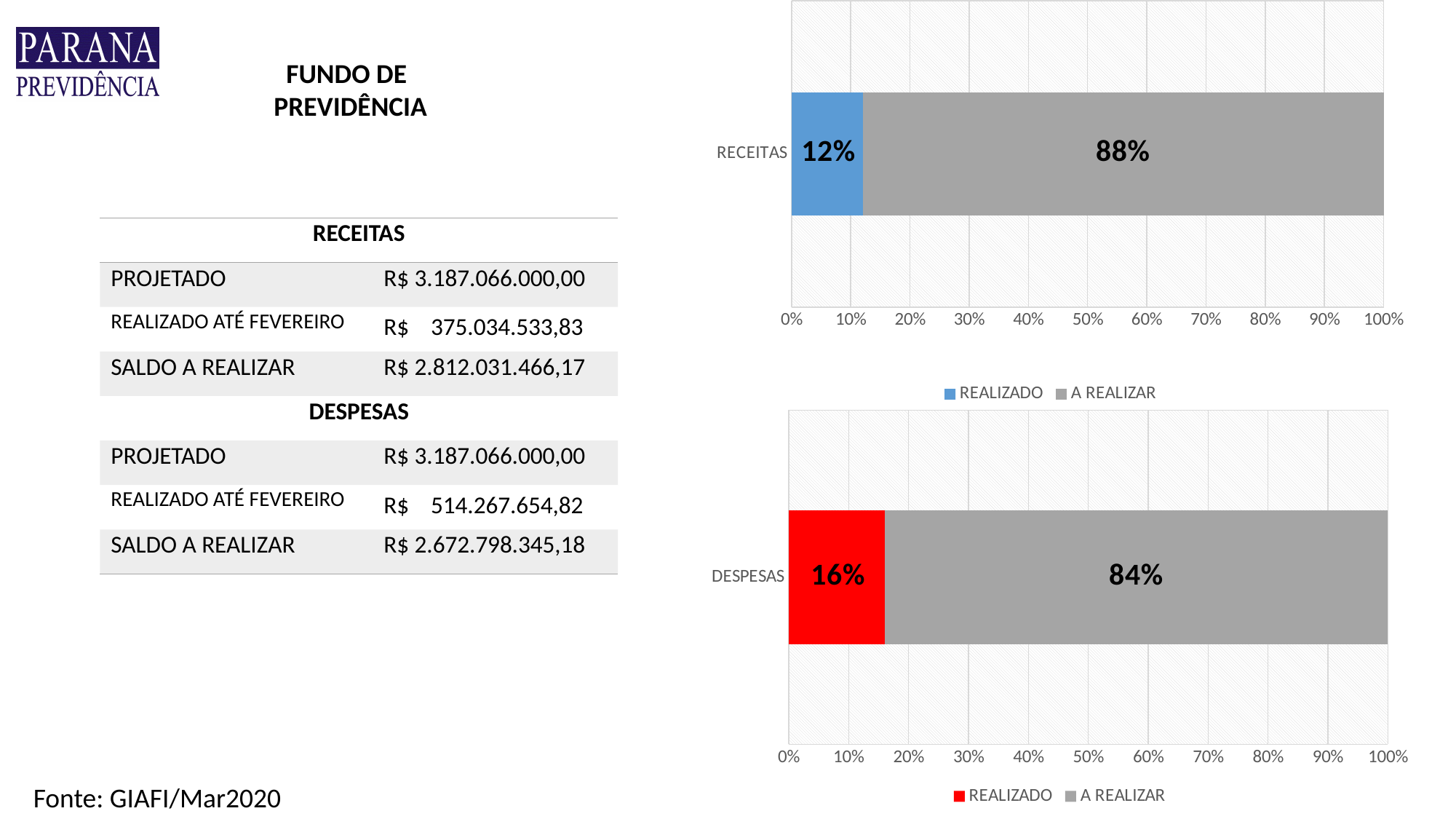
How many categories are plotted in the bottom chart (DESPESAS)? 1 In the bottom chart (DESPESAS), what is the value for A REALIZAR? 84% In the bottom chart (DESPESAS), what colour is the REALIZADO segment? Red What kind of chart is the bottom chart (DESPESAS)? Stacked bar chart In the top chart (RECEITAS), what is the value for A REALIZAR? 88% In the bottom chart (DESPESAS), what is the difference between A REALIZAR and REALIZADO? 68% In the top chart (RECEITAS), which series is larger, REALIZADO or A REALIZAR? A REALIZAR In the top chart (RECEITAS), what is the total of the stacked bar? 100% In the top chart (RECEITAS), what is the difference between A REALIZAR and REALIZADO? 76% In the bottom chart (DESPESAS), what is the value for REALIZADO? 16% In the top chart (RECEITAS), what is the value for REALIZADO? 12% How many series does the legend of the top chart (RECEITAS) list? 2